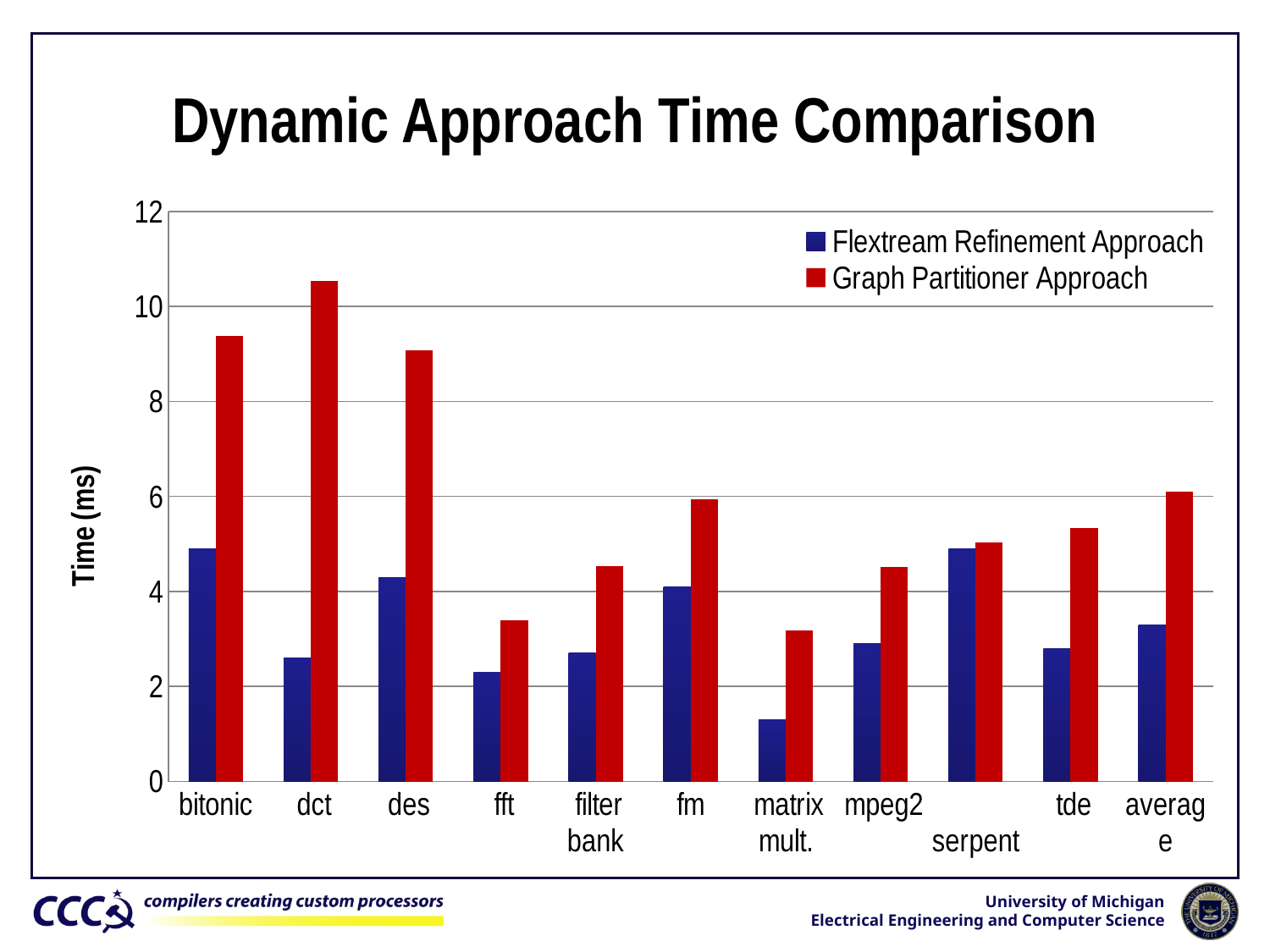
Is the Flextream Refinement Approach value for matrix mult. greater or less than 2? less What is the label of the y axis? Time (ms) Is the Flextream Refinement Approach value for fft greater or less than 4? less How many series does the legend list? 2 Which category has the lowest Flextream Refinement Approach time? matrix mult. Is the Graph Partitioner Approach value for dct greater or less than 10? greater Which category has the highest Graph Partitioner Approach time? dct What kind of chart is shown on the slide? bar chart For bitonic, which approach has the larger time, Flextream Refinement Approach or Graph Partitioner Approach? Graph Partitioner Approach How many categories are shown on the x axis? 11 Which has the larger Flextream Refinement Approach time, bitonic or dct? bitonic